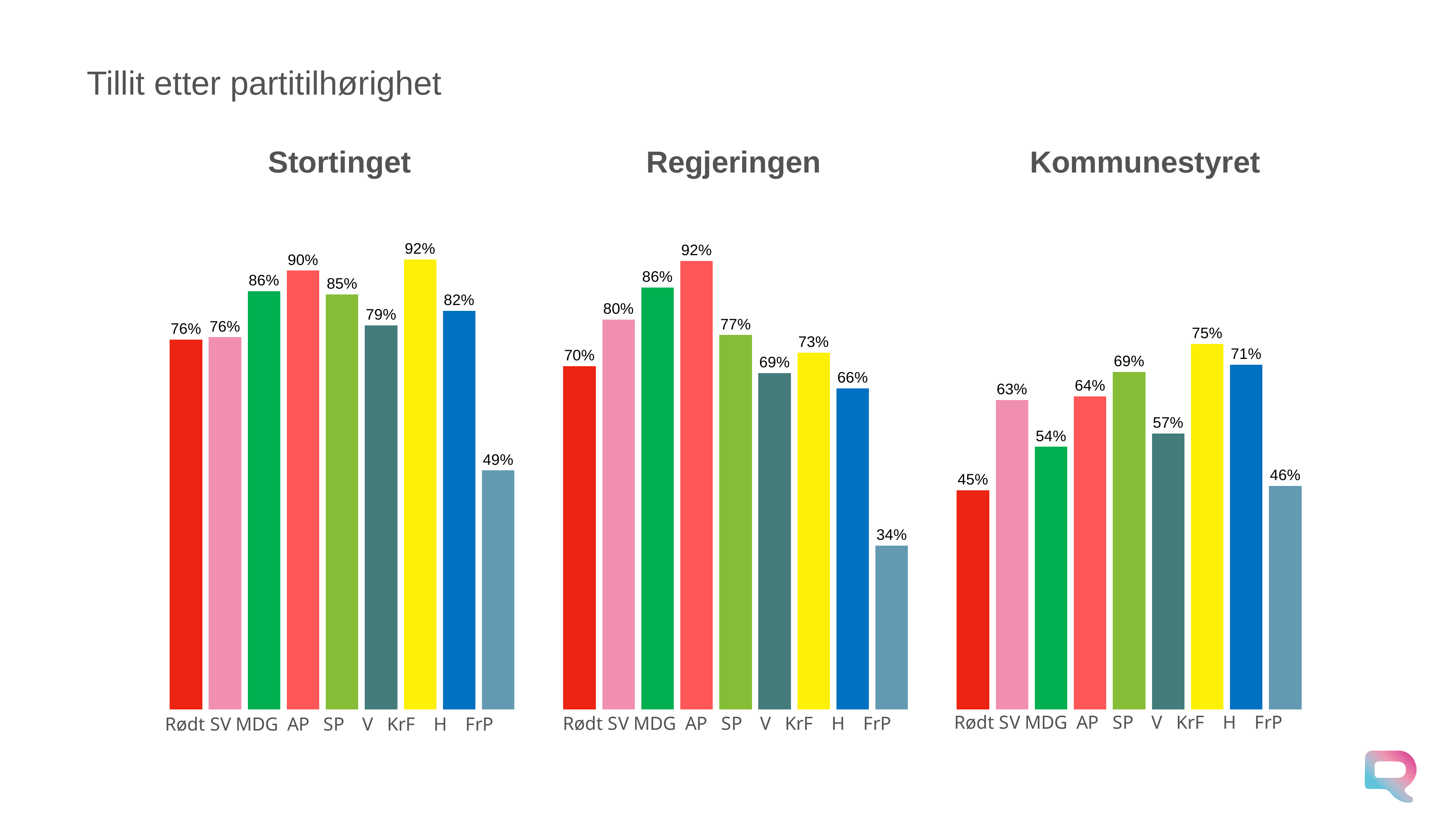
In the Stortinget chart, what is the value for KrF? 92% In the Regjeringen chart, what is the value for AP? 92% How many parties are shown in the Stortinget chart? 9 In the Regjeringen chart, which party has the highest value? AP In the Kommunestyret chart, which party has the highest value? KrF In the Stortinget chart, which party has the lowest value? FrP What is the title of the slide? Tillit etter partitilhørighet In the Stortinget chart, what is the difference between the values for MDG and V? 7% In the Kommunestyret chart, what is the value for Rødt? 45% In the Regjeringen chart, what is the difference between the values for AP and FrP? 58% What kind of chart is the Regjeringen chart? bar chart In the Kommunestyret chart, which is larger, the value for H or the value for SP? H